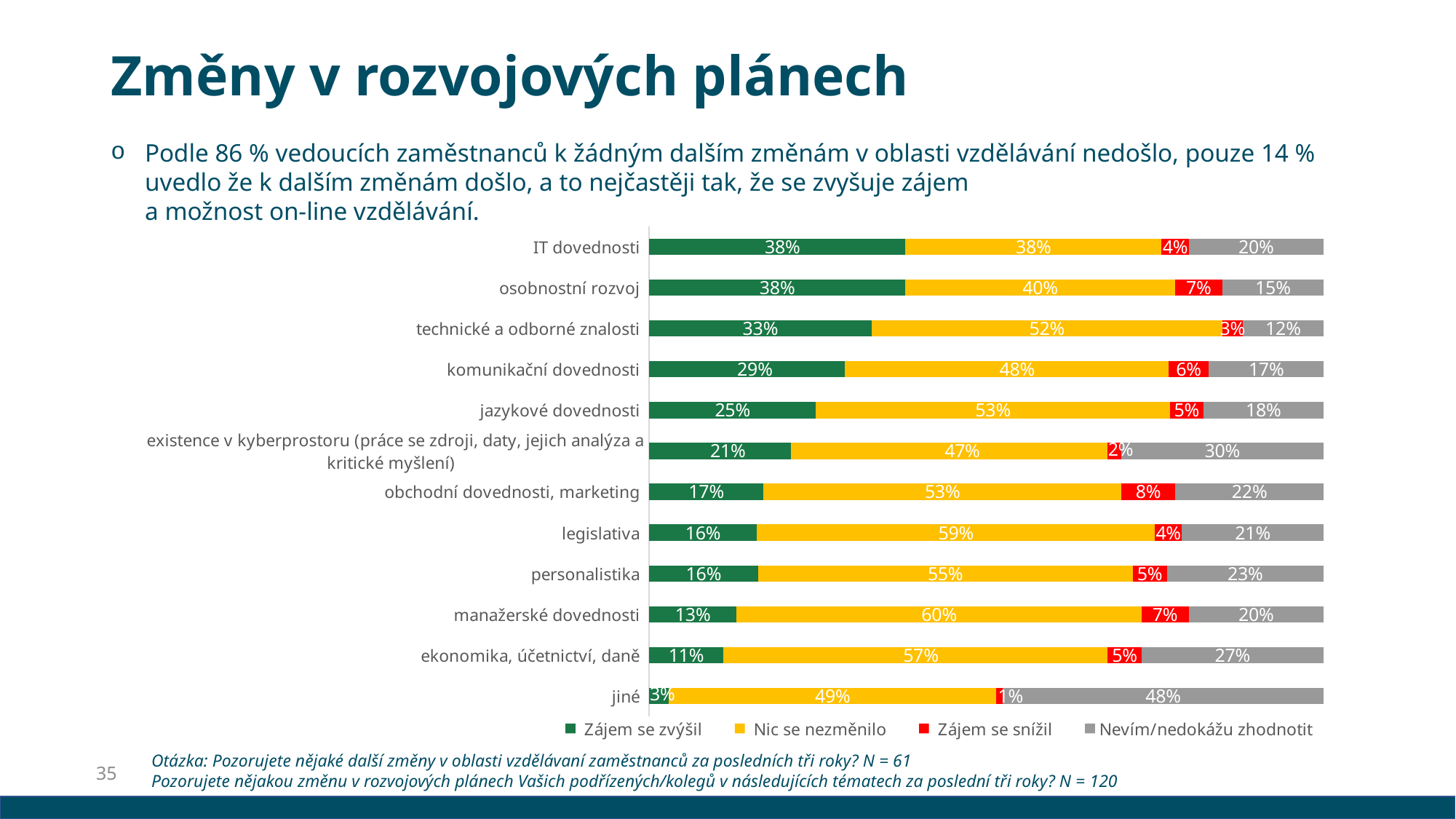
What is the "Nevím/nedokážu zhodnotit" value for existence v kyberprostoru? 30% Which category has the lowest "Nevím/nedokážu zhodnotit" value? technické a odborné znalosti Which is larger: the "Zájem se snížil" value for osobnostní rozvoj or for legislativa? osobnostní rozvoj How many series does the legend list? 4 Which category has the highest "Nic se nezměnilo" value? manažerské dovednosti Which category has the lowest "Zájem se zvýšil" value? jiné What is the "Nic se nezměnilo" value for manažerské dovednosti? 60% How many categories are shown in the chart? 12 What percentage of respondents said "Zájem se zvýšil" for IT dovednosti? 38% What is the difference between the "Zájem se zvýšil" values for jazykové dovednosti and ekonomika, účetnictví, daně? 14% What type of chart is shown on the slide? stacked bar chart Which category has the highest "Zájem se snížil" value? obchodní dovednosti, marketing